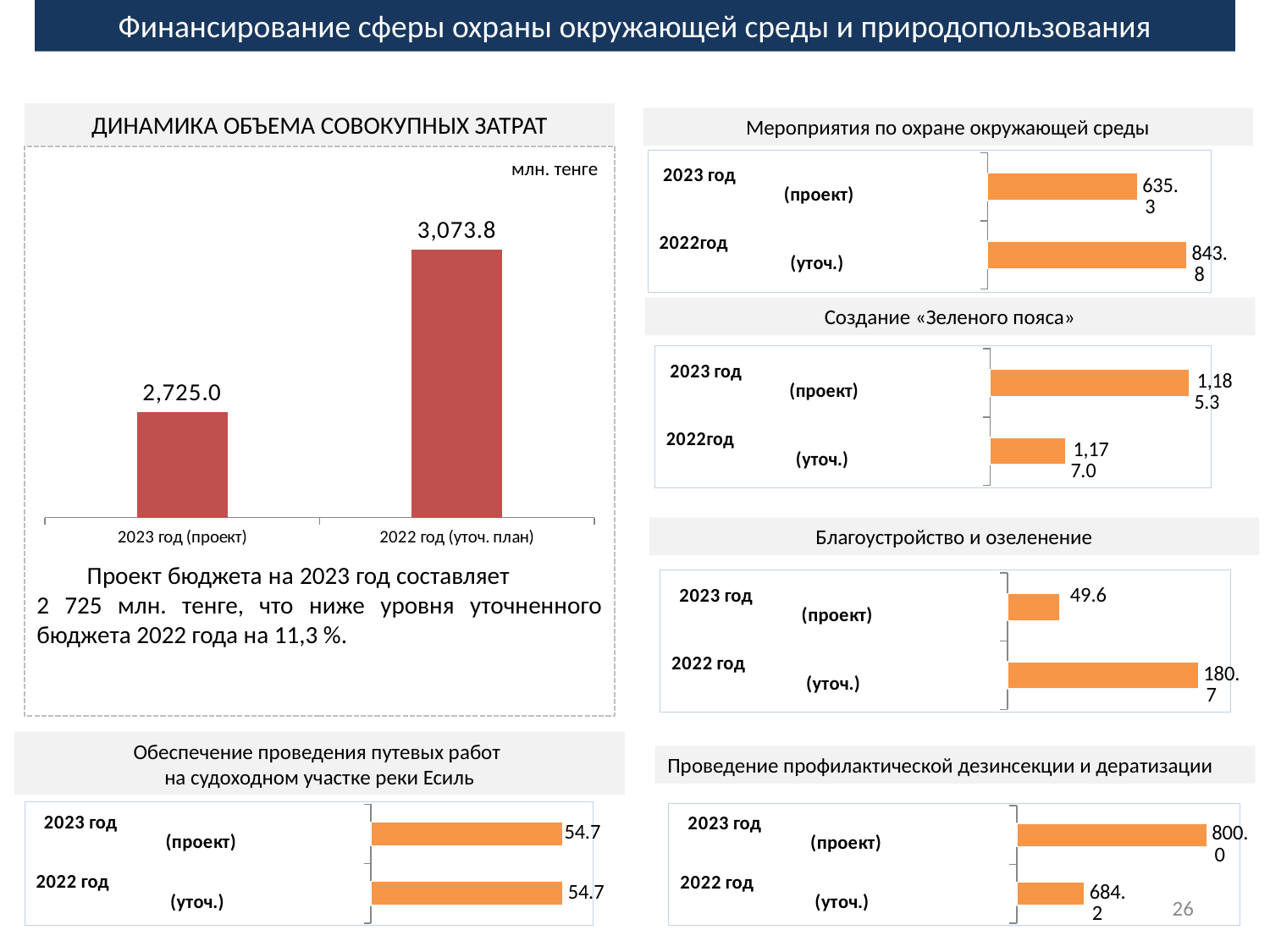
In the chart 'Благоустройство и озеленение', what is the difference between the 2022 год (уточ.) value and the 2023 год (проект) value? 131.1 In the chart 'Обеспечение проведения путевых работ на судоходном участке реки Есиль', what is the value for 2022 год (уточ.)? 54.7 What kind of chart is 'ДИНАМИКА ОБЪЕМА СОВОКУПНЫХ ЗАТРАТ'? Bar chart In the chart 'Проведение профилактической дезинсекции и дератизации', what is the value for 2023 год (проект)? 800.0 In the chart 'Мероприятия по охране окружающей среды', what is the value for 2023 год (проект)? 635.3 In the chart 'Мероприятия по охране окружающей среды', which year has the higher value? 2022 год (уточ.) In the chart 'Благоустройство и озеленение', what is the value for 2023 год (проект)? 49.6 In the chart 'ДИНАМИКА ОБЪЕМА СОВОКУПНЫХ ЗАТРАТ', what is the difference between the 2022 год (уточ. план) value and the 2023 год (проект) value? 348.8 In the chart 'ДИНАМИКА ОБЪЕМА СОВОКУПНЫХ ЗАТРАТ', what is the value for 2022 год (уточ. план)? 3,073.8 In the chart 'Проведение профилактической дезинсекции и дератизации', which year has the lower value? 2022 год (уточ.) In the chart 'ДИНАМИКА ОБЪЕМА СОВОКУПНЫХ ЗАТРАТ', what is the value for 2023 год (проект)? 2,725.0 In the chart 'Создание «Зеленого пояса»', what is the value for 2022 год (уточ.)? 1,177.0